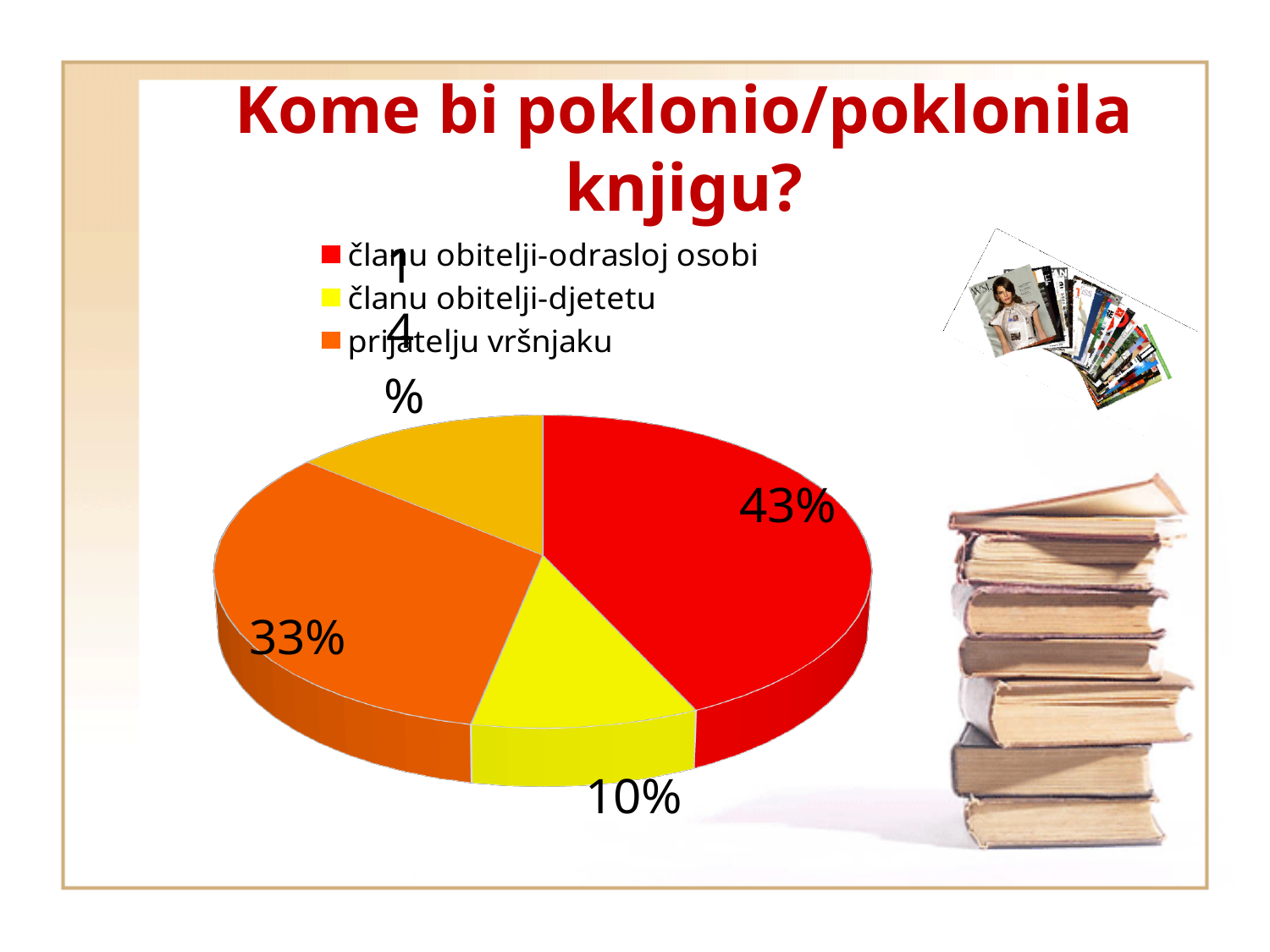
How many entries does the legend list? 3 What is the difference in percentage points between 'članu obitelji-odrasloj osobi' and 'prijatelju vršnjaku'? 10 percentage points What is the difference in percentage points between 'članu obitelji-odrasloj osobi' and 'članu obitelji-djetetu'? 33 percentage points Which is larger: the slice for 'prijatelju vršnjaku' or the slice for 'članu obitelji-djetetu'? prijatelju vršnjaku Which category has the largest slice of the pie? članu obitelji-odrasloj osobi What percentage of the pie is for 'prijatelju vršnjaku'? 33% What percentage of the pie is for 'članu obitelji-odrasloj osobi'? 43% What colour is the slice for 'članu obitelji-odrasloj osobi'? Red What percentage of the pie is for 'članu obitelji-djetetu'? 10% Which legend category has the smallest slice of the pie? članu obitelji-djetetu How many slices does the pie chart have? 4 What type of chart is shown on the slide? Pie chart